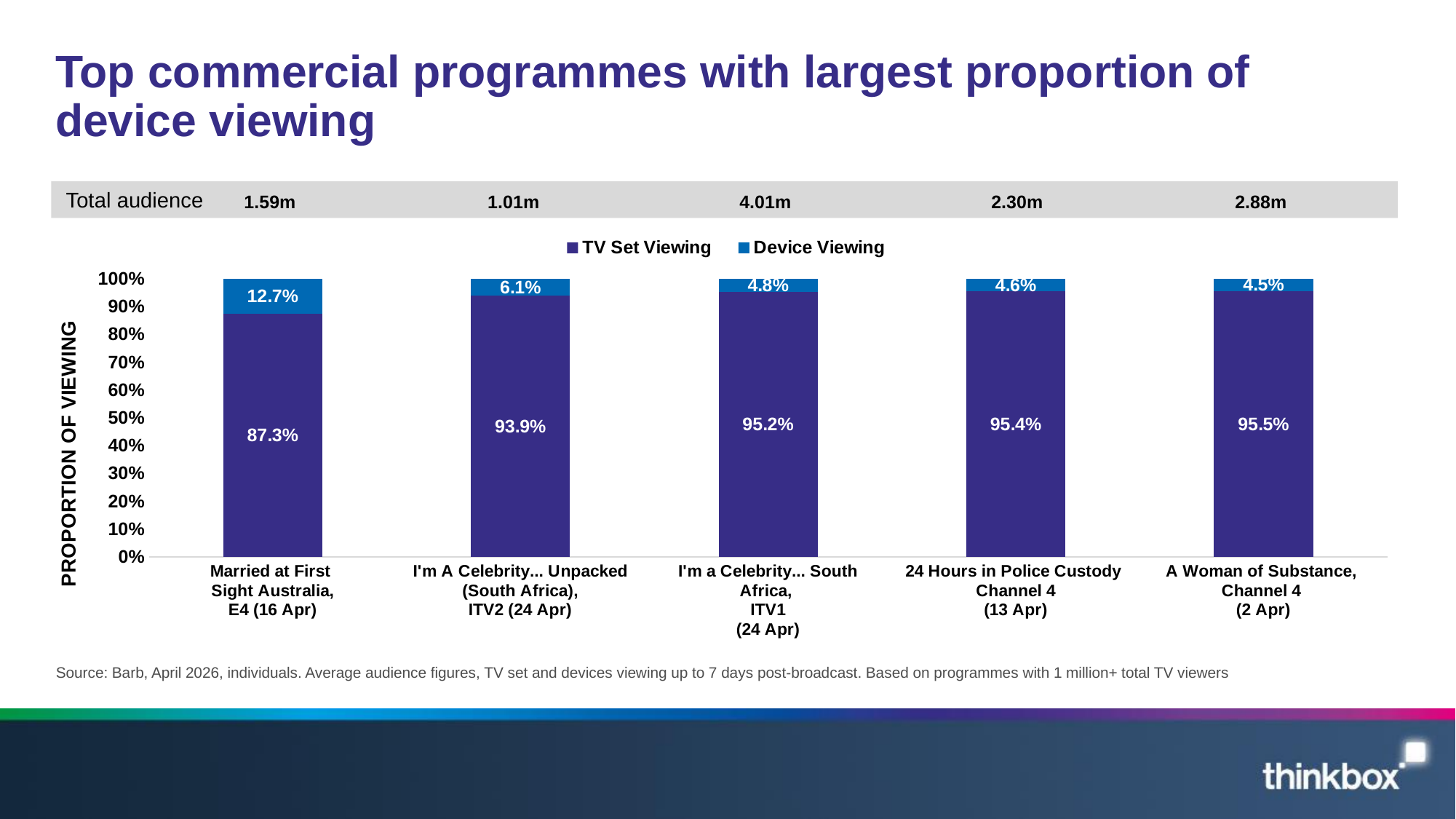
What is the total audience shown for I'm a Celebrity... South Africa, ITV1 (24 Apr)? 4.01m What is the Device Viewing proportion for Married at First Sight Australia, E4 (16 Apr)? 12.7% What is the Device Viewing proportion for A Woman of Substance, Channel 4 (2 Apr)? 4.5% Which programme has the highest Device Viewing proportion? Married at First Sight Australia, E4 (16 Apr) How many series does the legend list? 2 What kind of chart is shown on the slide? Stacked bar chart What is the TV Set Viewing proportion for I'm A Celebrity... Unpacked (South Africa), ITV2 (24 Apr)? 93.9% What is the difference between the Device Viewing proportions of Married at First Sight Australia and I'm A Celebrity... Unpacked (South Africa)? 6.6% How many programmes are shown on the chart? 5 Which programme has the lowest TV Set Viewing proportion? Married at First Sight Australia, E4 (16 Apr) Which is larger: the Device Viewing proportion for I'm a Celebrity... South Africa, ITV1 or for 24 Hours in Police Custody, Channel 4? I'm a Celebrity... South Africa, ITV1 Is the TV Set Viewing proportion for Married at First Sight Australia greater or less than 90%? less